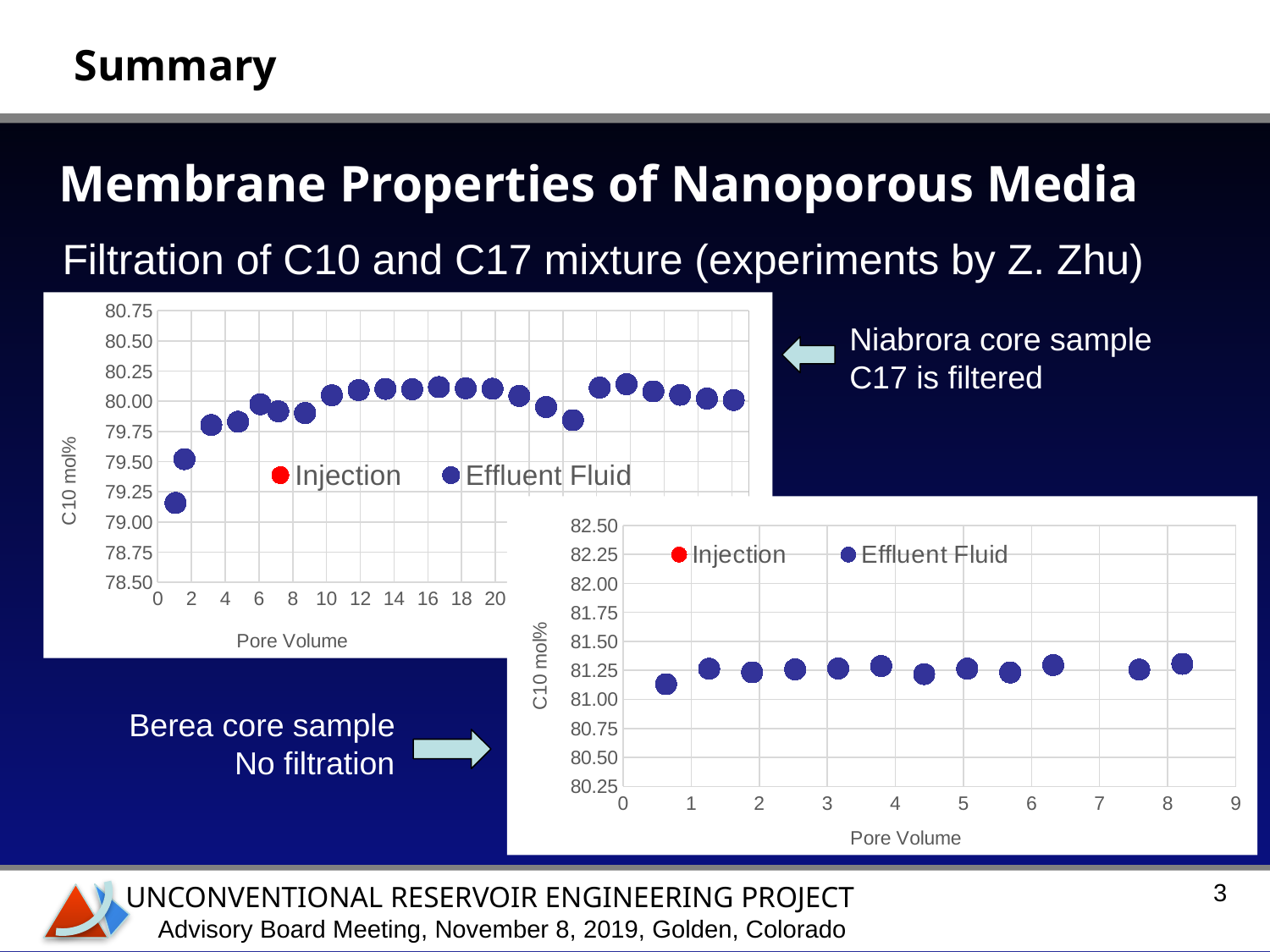
In the upper-left chart, is the Effluent Fluid value at about pore volume 14 greater or less than 80.00? greater What are the two legend entries in the lower-right chart? Injection, Effluent Fluid In the upper-left chart, which is larger: the Effluent Fluid value at about pore volume 1 or at about pore volume 12? pore volume 12 How many Effluent Fluid points are plotted in the lower-right chart (Berea core sample)? 12 What kind of chart is the lower-right chart (Berea core sample)? scatter chart What kind of chart is the upper-left chart (Niabrora core sample)? scatter chart In the upper-left chart, is the first Effluent Fluid point (near pore volume 0.5) greater or less than 79.50? less What is the y-axis title of the lower-right chart? C10 mol% In the upper-left chart, do the Effluent Fluid values rise or fall over the first few pore volumes (from 0 to about 6)? rise In the lower-right chart, are all the Effluent Fluid points greater or less than 81.50? less How many series does the legend of the upper-left chart list? 2